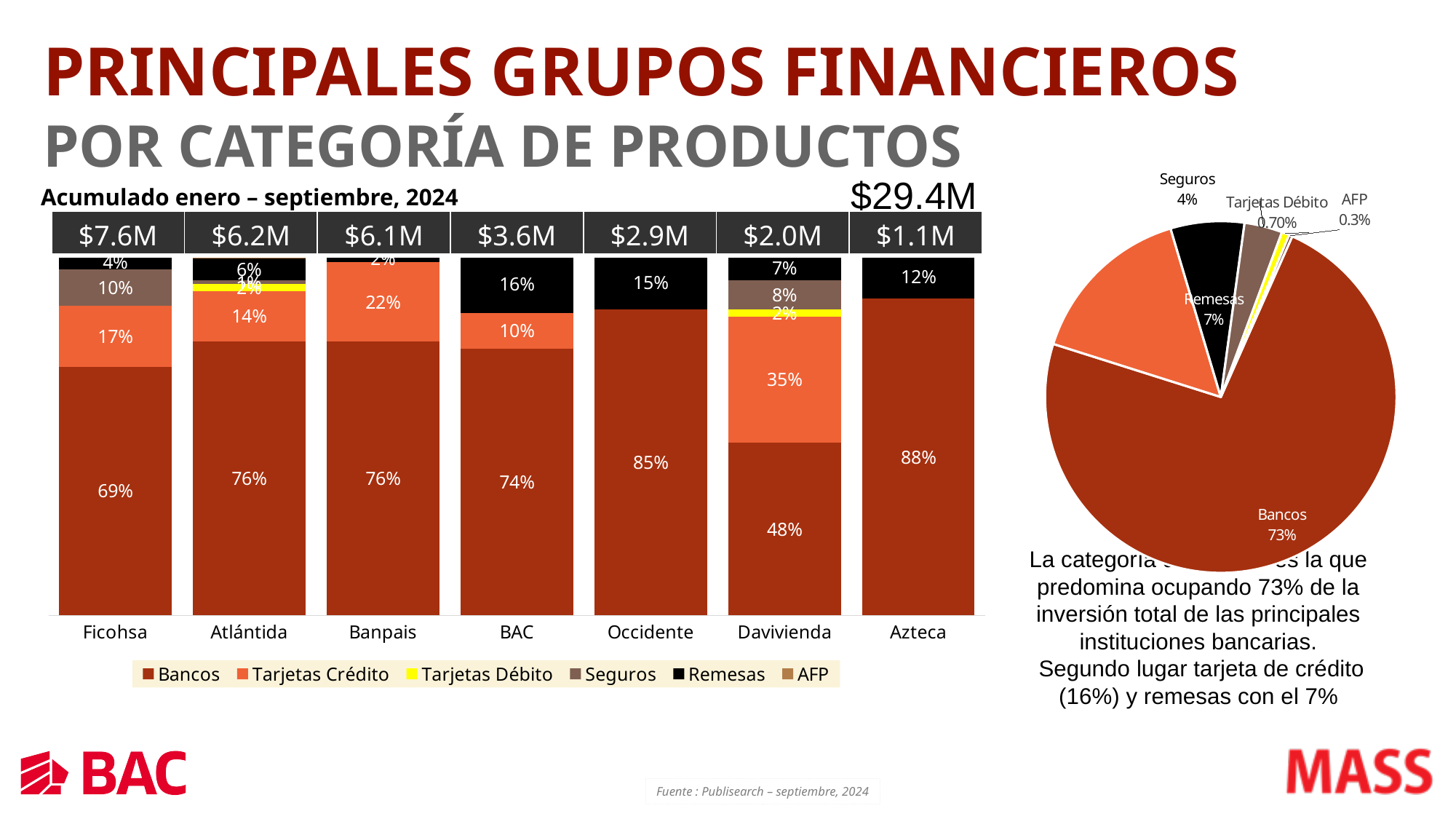
In the bar chart on the left, what is the difference between the Bancos percentage for Azteca and for Davivienda? 40% What kind of chart is the chart on the left of the slide? Stacked bar chart In the bar chart on the left, how many product categories does the legend list? 6 What kind of chart is the chart on the right of the slide? Pie chart In the bar chart on the left, how many financial groups are shown on the x axis? 7 In the bar chart on the left, what percentage does Tarjetas Crédito represent for Davivienda? 35% In the bar chart on the left, which financial group has the highest Bancos percentage? Azteca In the bar chart on the left, which has a larger Tarjetas Crédito percentage, Banpais or Ficohsa? Banpais In the pie chart on the right, what share does Remesas have? 7% In the bar chart on the left, what total amount is shown above the Ficohsa bar? $7.6M In the bar chart on the left, what percentage does Bancos represent for Occidente? 85% In the bar chart on the left, which financial group has the lowest Bancos percentage? Davivienda